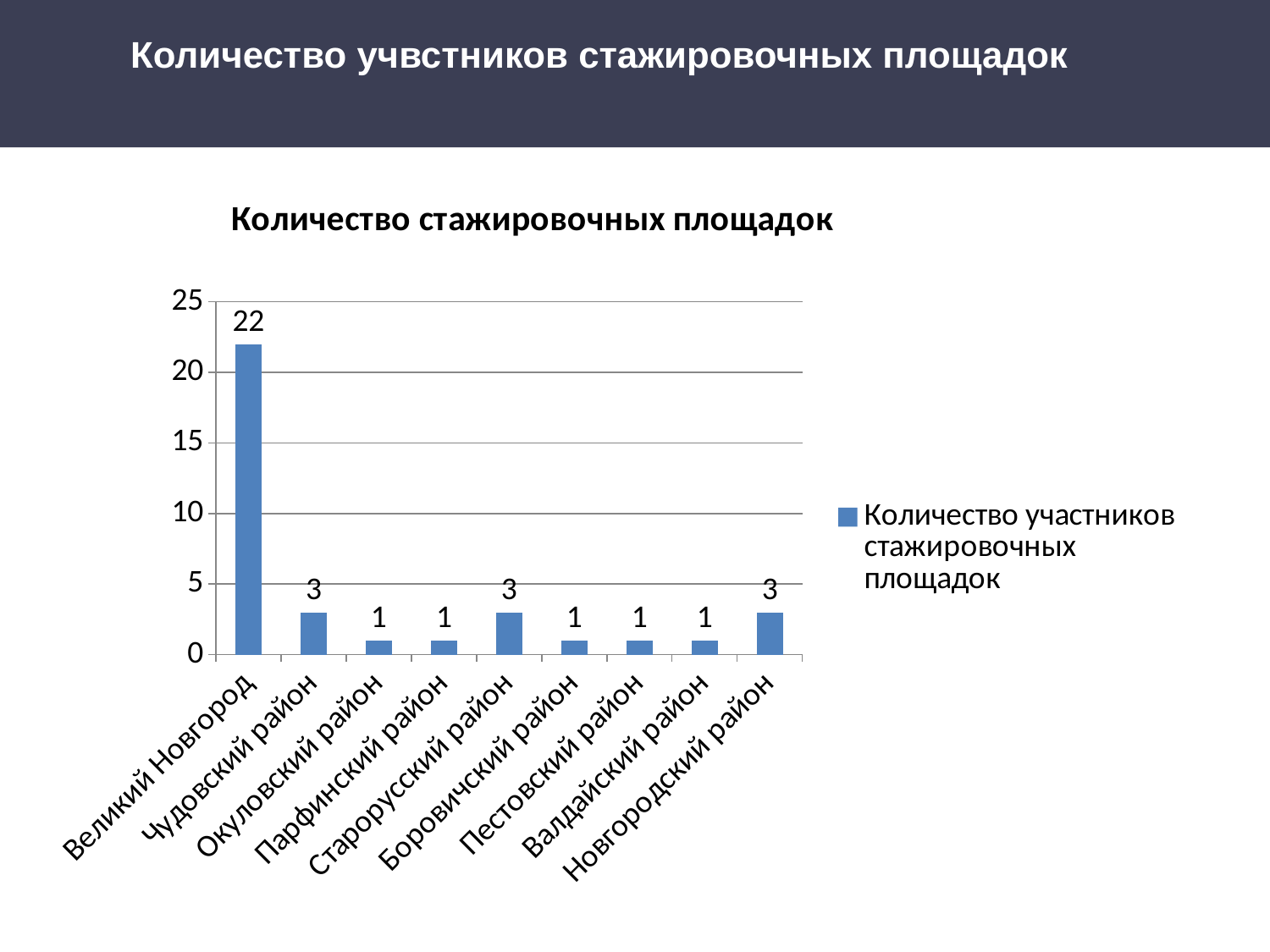
What is the value for Старорусский район? 3 What is the legend entry for the series? Количество участников стажировочных площадок What is the value for Великий Новгород? 22 What is the title of the chart? Количество стажировочных площадок Which category has the highest value? Великий Новгород Is the value for Великий Новгород greater or less than 20? greater What is the value for Пестовский район? 1 How many series does the legend list? 1 What is the difference between the values for Великий Новгород and Чудовский район? 19 Which is larger, the value for Новгородский район or the value for Валдайский район? Новгородский район What kind of chart is shown? bar chart How many categories are shown on the x axis? 9